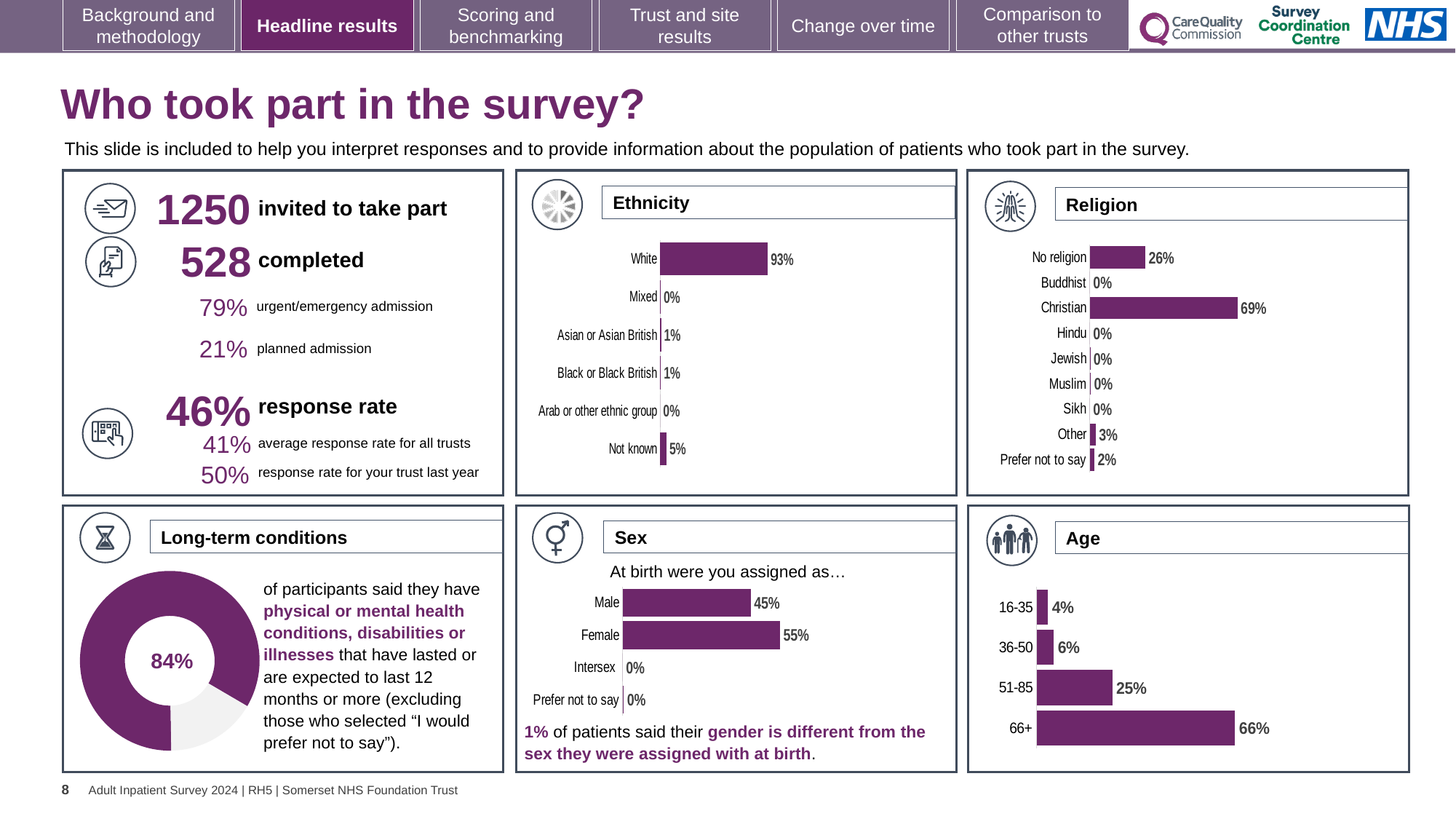
In the Ethnicity chart, what is the value for Not known? 5% In the Religion chart, what is the value for No religion? 26% In the Religion chart, which category has the highest value? Christian In the Age chart, which age group has the lowest value? 16-35 In the Ethnicity chart, what is the value for White? 93% How many categories does the Age chart show? 4 In the Long-term conditions chart, what share of participants said they have long-term conditions? 84% What kind of chart is the Long-term conditions chart? Doughnut chart How many categories does the Religion chart show? 9 In the Age chart, what is the value for 66+? 66% In the Sex chart, what is the difference between the Female and Male values? 10% In the Sex chart, which is larger, Male or Female? Female